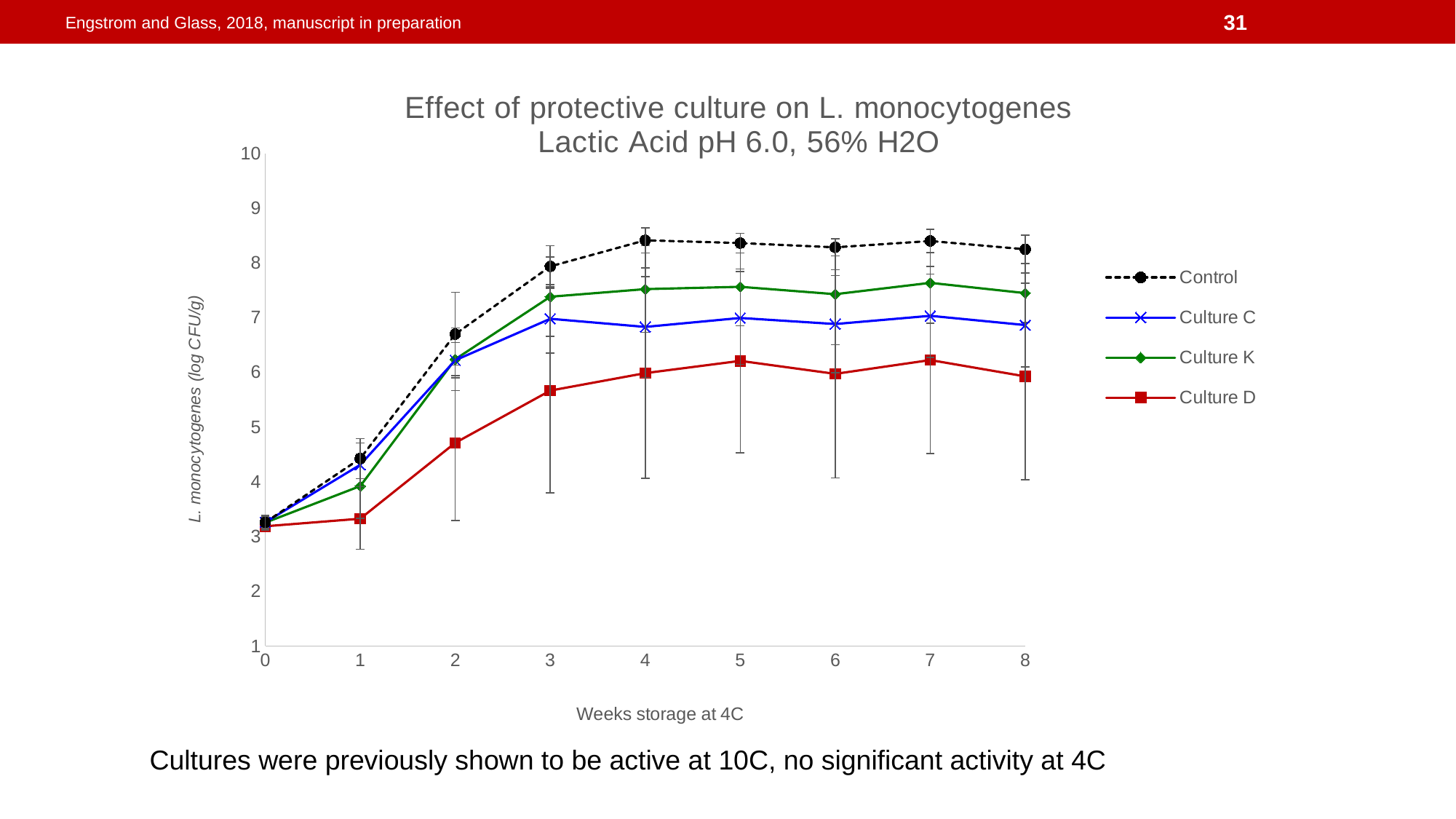
Which series has the lowest value at week 3? Culture D Is the value for Control at week 4 greater or less than 8? greater Is the value for Culture K at week 7 greater or less than 7? greater Does the Culture D series rise or fall from week 0 to week 3? rise What kind of chart is shown on the slide? line chart How many series does the legend list? 4 At week 8, which is higher: Culture K or Culture D? Culture K Which series is drawn with a dashed line? Control How many time points (weeks) are plotted along the x axis? 9 Which series has the highest value at week 5? Control Is the value for Culture D at week 1 greater or less than 4? less What is the label of the x axis? Weeks storage at 4C